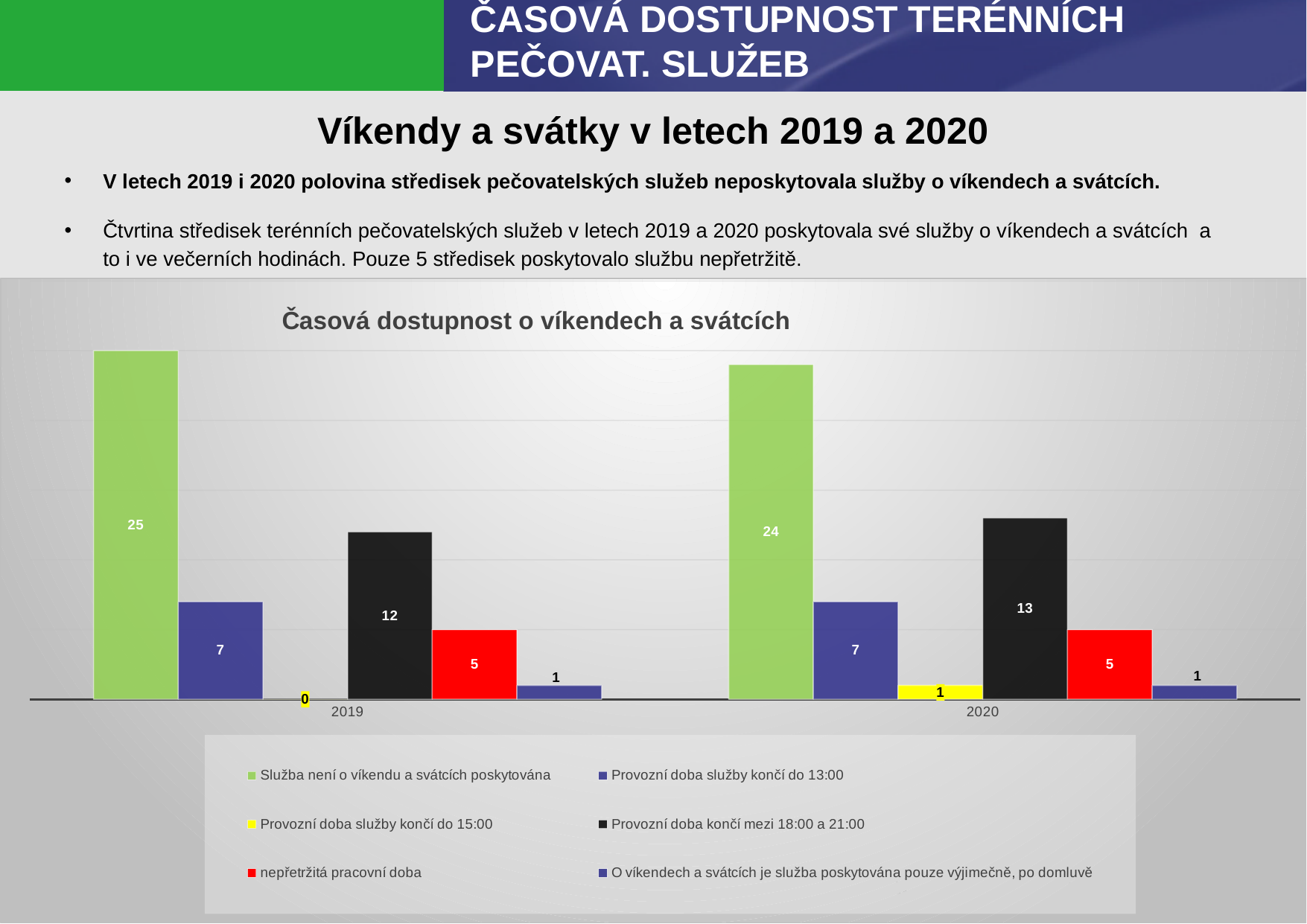
What is the value for 'Služba není o víkendu a svátcích poskytována' in 2020? 24 Which series has the highest value in 2020? Služba není o víkendu a svátcích poskytována How many year categories are shown on the x axis? 2 What is the value for 'Provozní doba končí mezi 18:00 a 21:00' in 2020? 13 What is the value for 'nepřetržitá pracovní doba' in 2019? 5 What type of chart is shown on the slide? bar chart What is the value for 'Provozní doba služby končí do 15:00' in 2019? 0 What is the value for 'Služba není o víkendu a svátcích poskytována' in 2019? 25 What is the title of the chart? Časová dostupnost o víkendech a svátcích What is the difference between 'Služba není o víkendu a svátcích poskytována' and 'Provozní doba končí mezi 18:00 a 21:00' in 2019? 13 Which is larger: 'Provozní doba končí mezi 18:00 a 21:00' in 2019 or in 2020? 2020 How many series does the chart legend list? 6